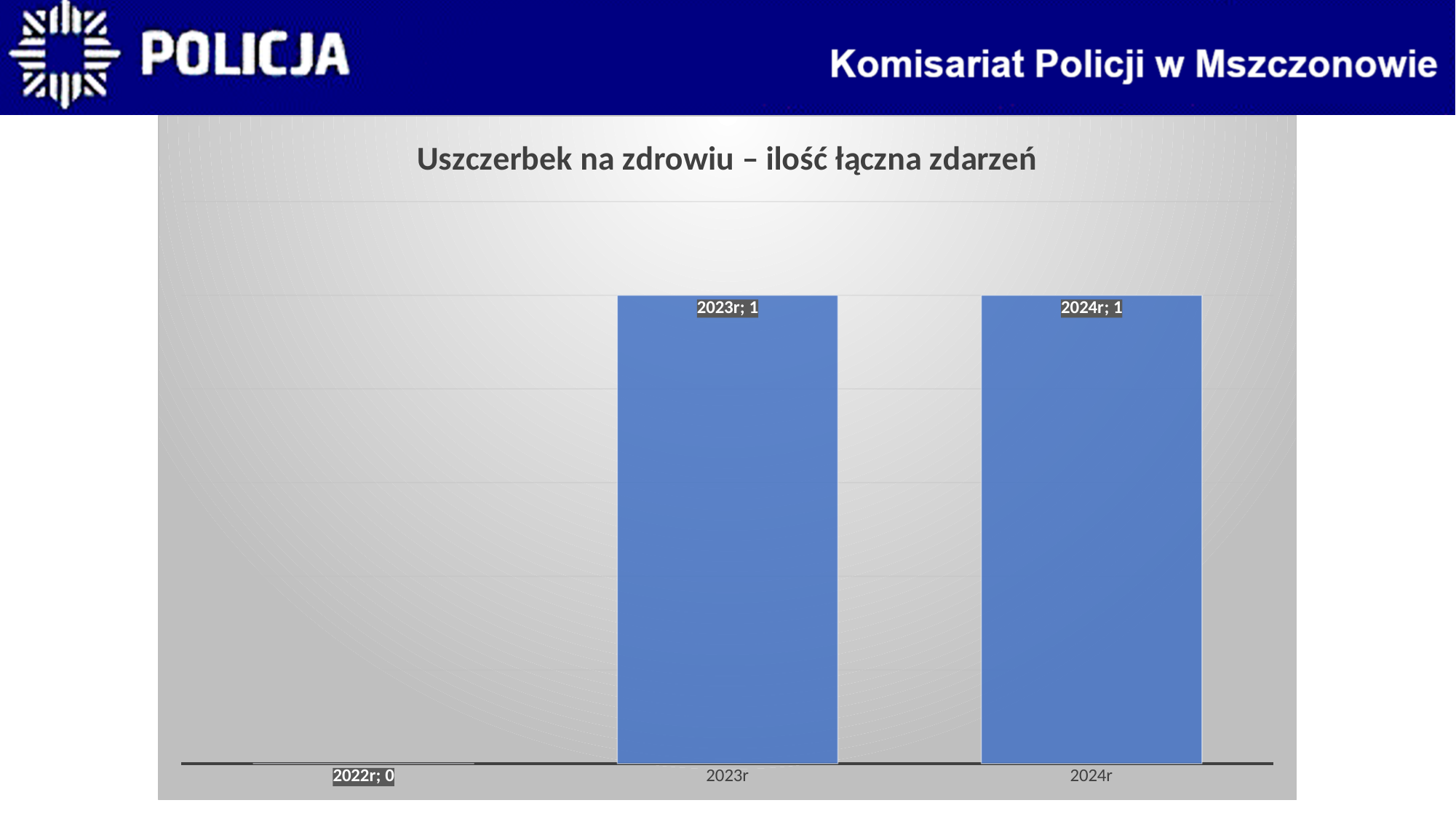
What is the value for 2022r? 0 What is the difference between the values for 2023r and 2022r? 1 Which is larger, the value for 2022r or the value for 2024r? 2024r What is the value for 2023r? 1 What colour are the bars in the chart? blue What is the value for 2024r? 1 What kind of chart is shown on the slide? bar chart Which category has the lowest value? 2022r Do the values rise or fall from 2022r to 2023r? rise What is the title of the chart? Uszczerbek na zdrowiu – ilość łączna zdarzeń How many categories are shown on the x axis? 3